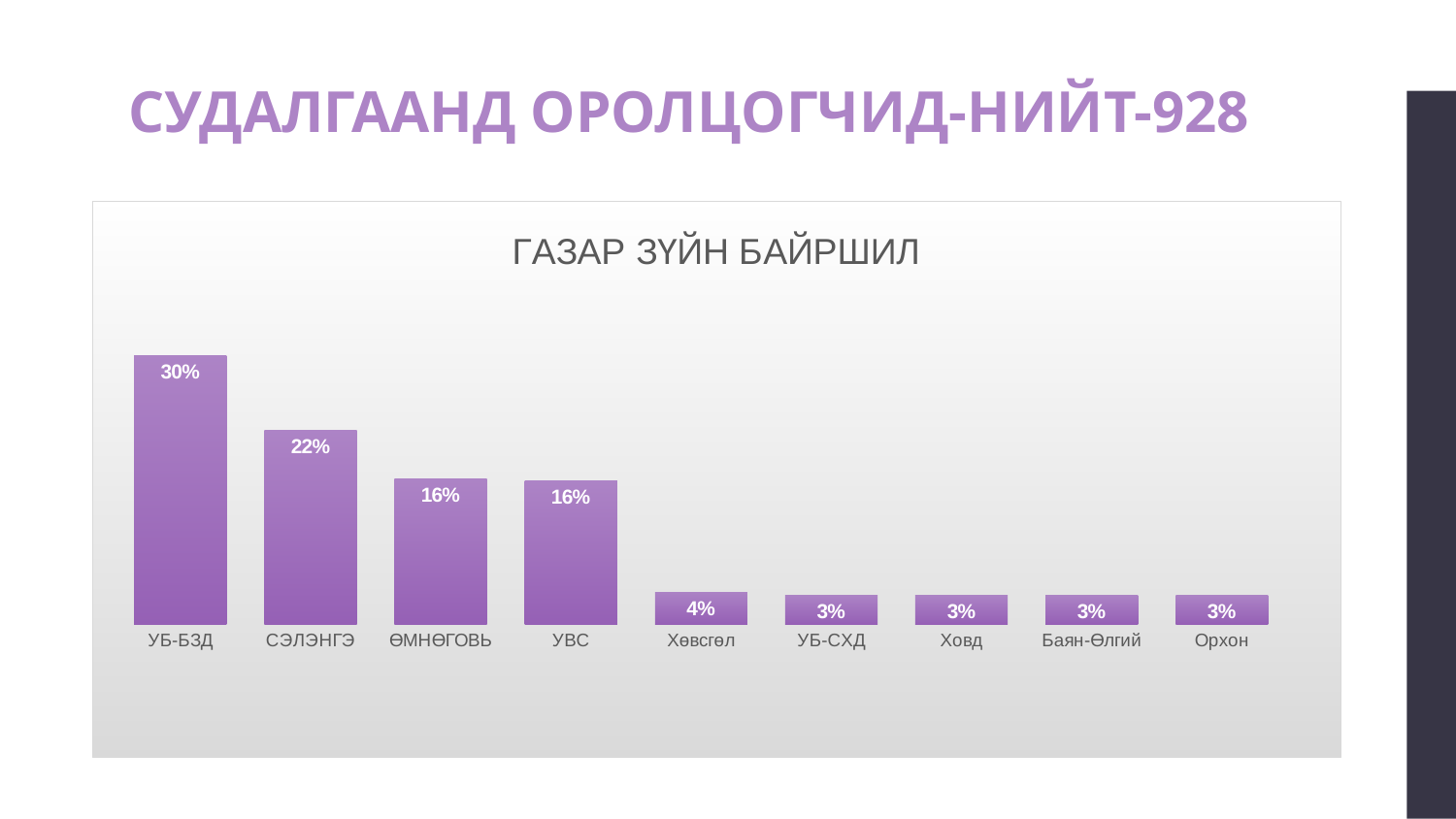
What is the difference between the values for ӨМНӨГОВЬ and Хөвсгөл? 12% What is the value for УБ-БЗД? 30% Which is larger, the value for СЭЛЭНГЭ or the value for УВС? СЭЛЭНГЭ What is the value for Хөвсгөл? 4% What is the title of the chart? ГАЗАР ЗҮЙН БАЙРШИЛ What is the value for СЭЛЭНГЭ? 22% What is the value for Баян-Өлгий? 3% Which category has the highest value? УБ-БЗД How many categories are shown in the chart? 9 What is the difference between the values for УБ-БЗД and СЭЛЭНГЭ? 8% What kind of chart is shown on the slide? Bar chart Do the values rise or fall from left to right along the x axis? Fall